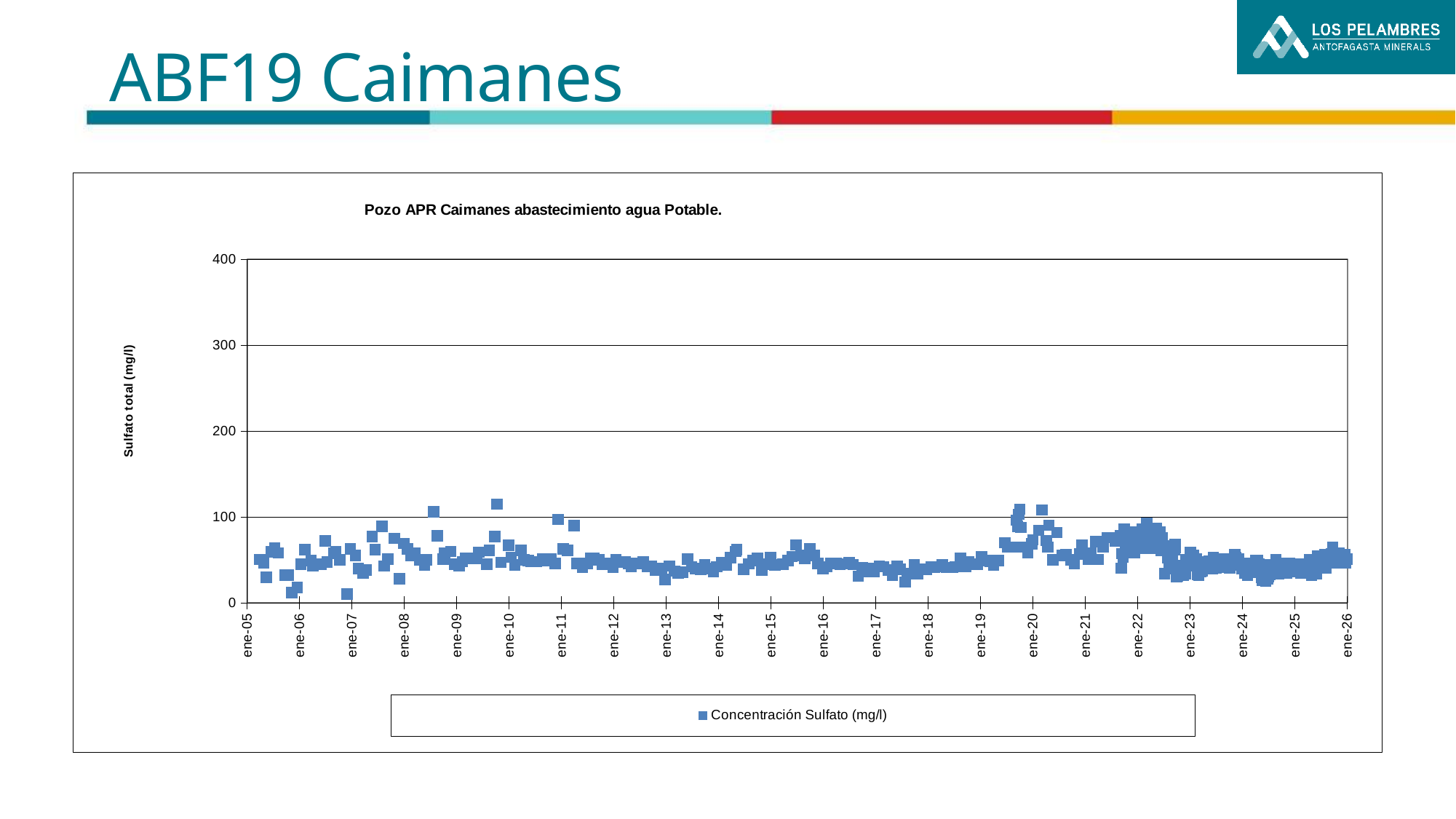
What is the highest value shown on the y axis? 400 What is the last label on the x axis? ene-26 What is the legend entry for the plotted series? Concentración Sulfato (mg/l) How many series does the legend list? 1 Is the plotted value near ene-18 greater or less than 100? less How many labels are shown on the x axis? 22 Is the lowest plotted value near ene-07 greater or less than 100? less Is the plotted value near ene-13 greater or less than 100? less What is the title of the chart? Pozo APR Caimanes abastecimiento agua Potable. What kind of chart is shown on the slide? scatter chart What is the first label on the x axis? ene-05